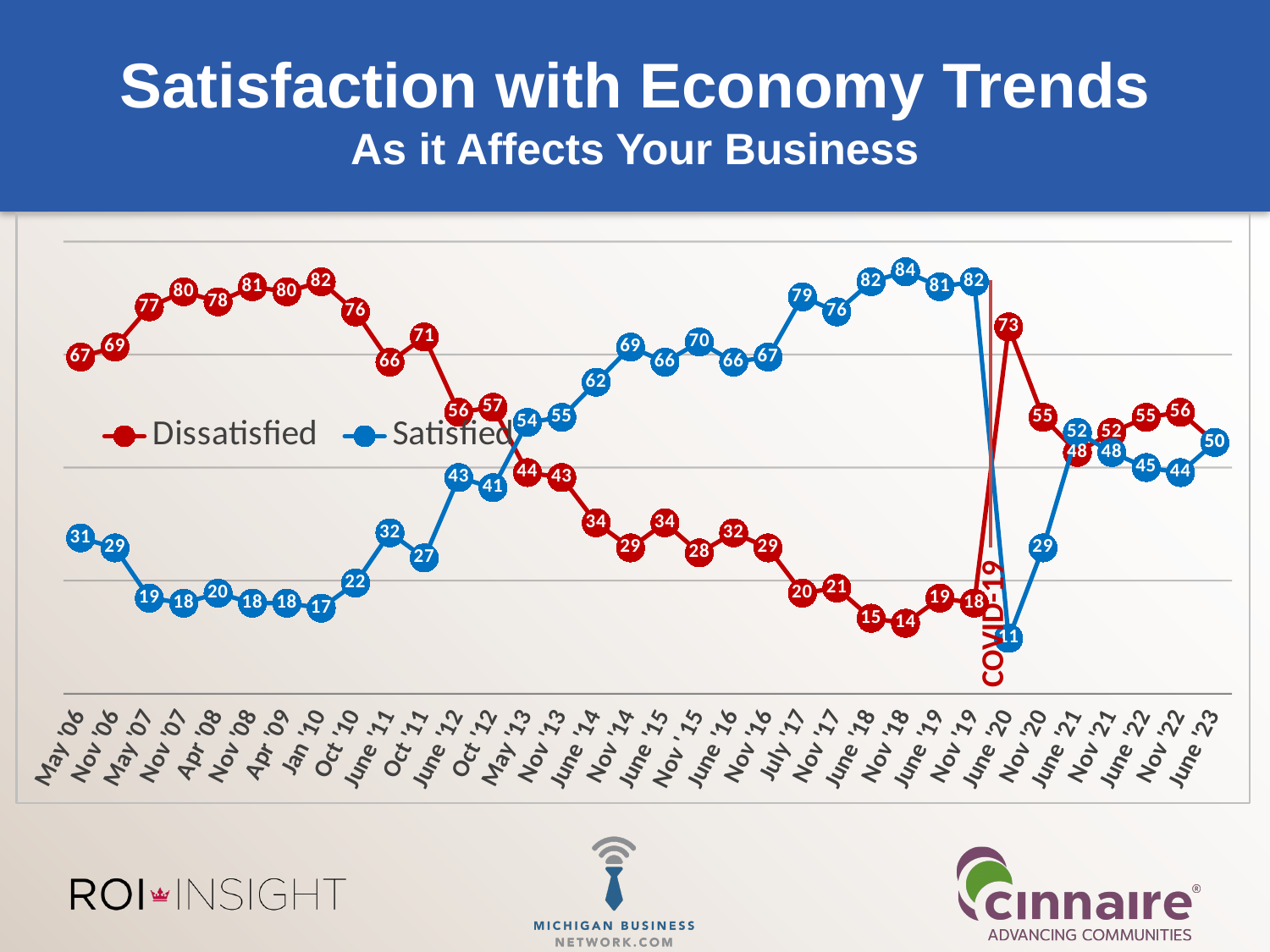
At which date does the Satisfied series reach its lowest value? June '20 How many series does the legend list? 2 What kind of chart is shown on the slide? line chart What event is annotated with a vertical label on the chart near June '20? COVID-19 By how much did the Satisfied value drop from Nov '19 to June '20? 71 At which date does the Dissatisfied series reach its lowest value? Nov '18 What is the Satisfied value for June '20? 11 At which date does the Satisfied series reach its highest value? Nov '18 At which date does the Dissatisfied series reach its highest value? Jan '10 What is the Satisfied value for Nov '22? 44 In May '06, which series has the larger value, Dissatisfied or Satisfied? Dissatisfied What is the Dissatisfied value for June '20? 73